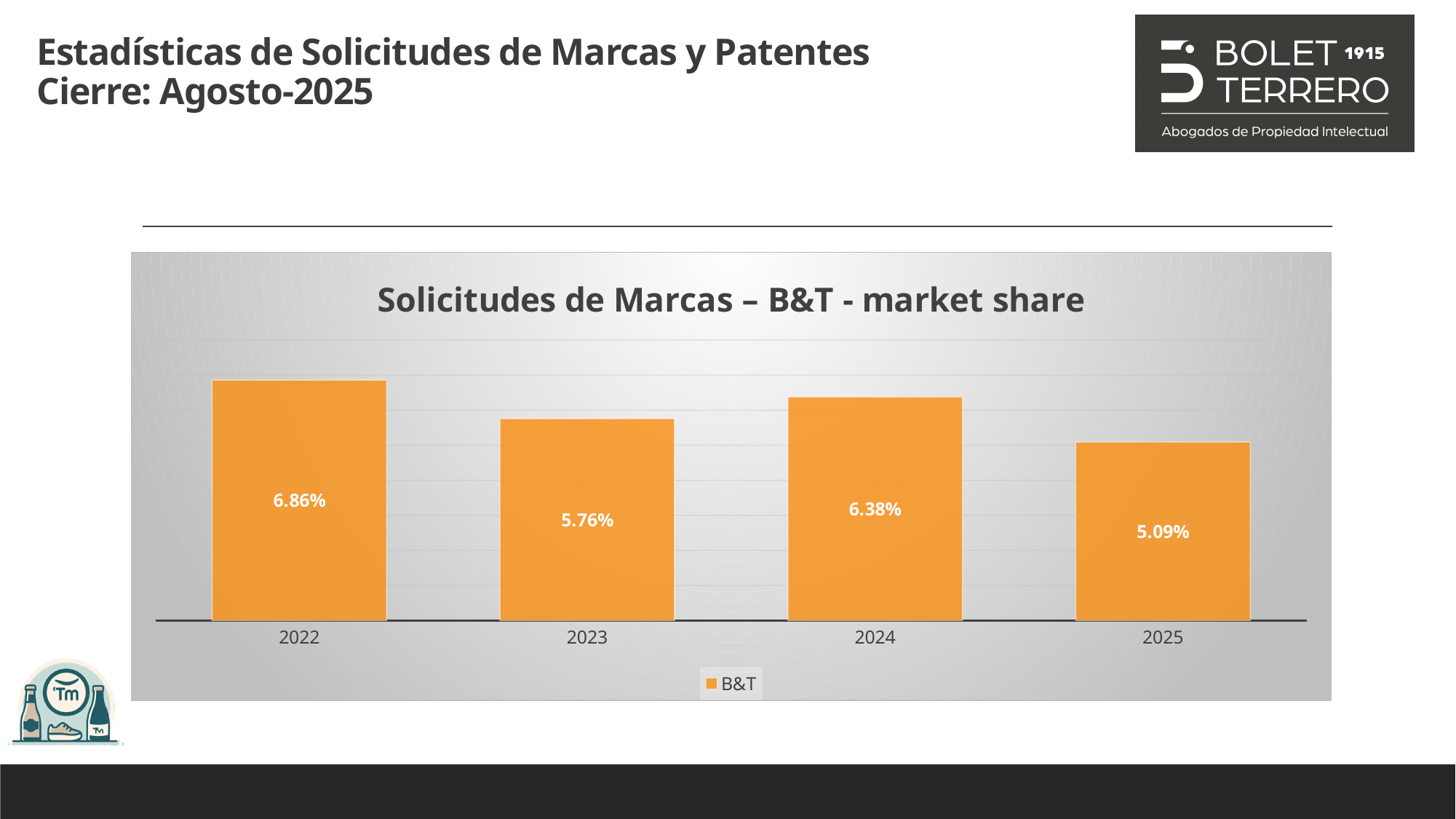
Which year has the highest B&T market share? 2022 What kind of chart is shown on the slide? Bar chart What is the difference between the B&T market share in 2022 and in 2025? 1.77% What is the B&T market share value for 2022? 6.86% What is the B&T market share value for 2025? 5.09% What is the B&T market share value for 2023? 5.76% What is the title of the chart? Solicitudes de Marcas – B&T - market share How many series does the legend list? 1 Which year has a larger B&T market share, 2023 or 2024? 2024 What is the B&T market share value for 2024? 6.38% How many years are shown on the x axis of the chart? 4 Which year has the lowest B&T market share? 2025